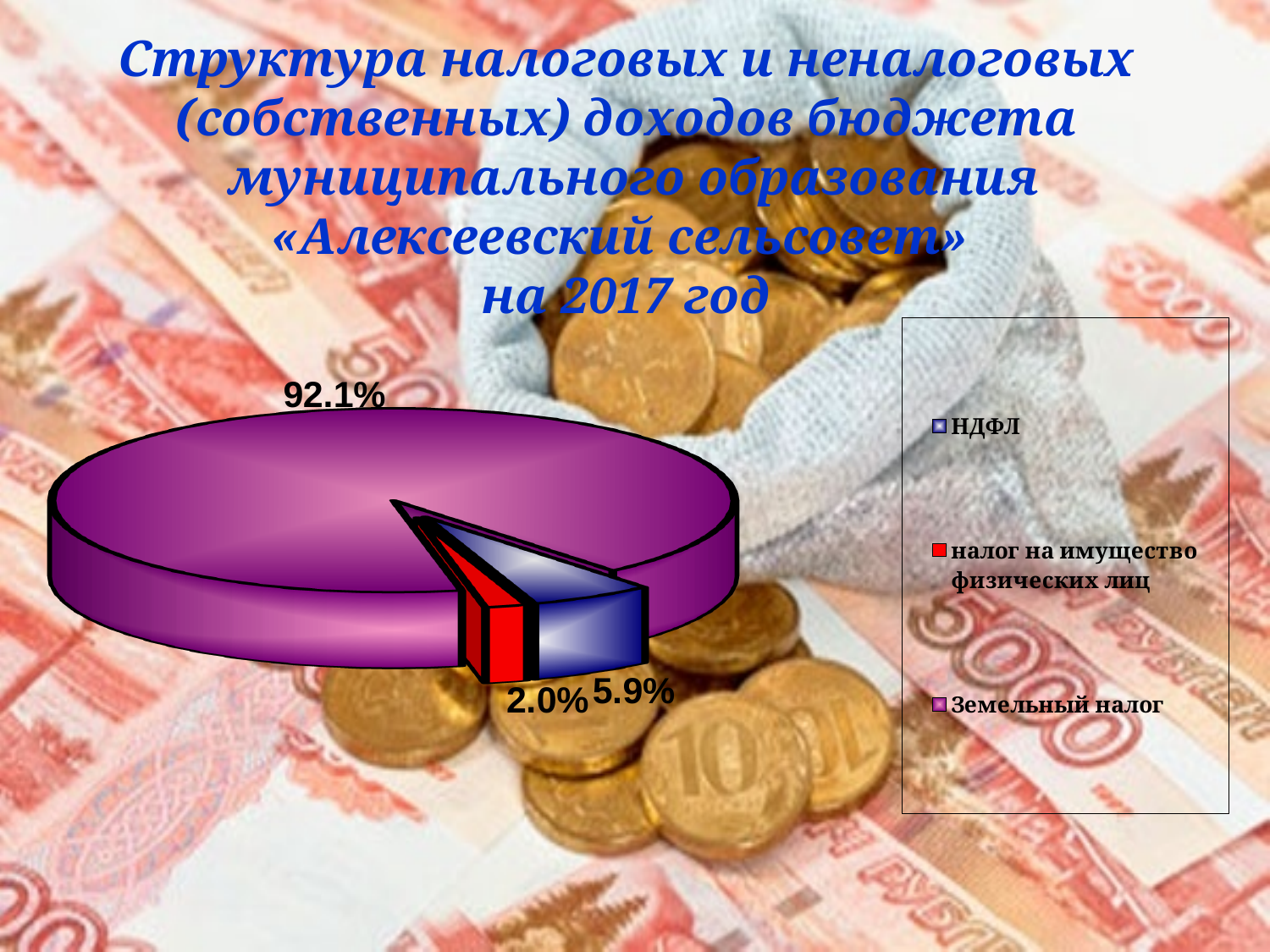
What is the difference in percentage points between Земельный налог and НДФЛ? 86.2 Which category has the smallest share of the pie? налог на имущество физических лиц What share of the pie does налог на имущество физических лиц have? 2.0% How many entries does the legend list? 3 Which is larger, the share for НДФЛ or the share for налог на имущество физических лиц? НДФЛ How many slices does the pie chart have? 3 Which category has the largest share of the pie? Земельный налог What share of the pie does НДФЛ have? 5.9% What colour is the slice for Земельный налог? purple What share of the pie does Земельный налог have? 92.1% What kind of chart is shown on the slide? pie chart What is the difference in percentage points between НДФЛ and налог на имущество физических лиц? 3.9